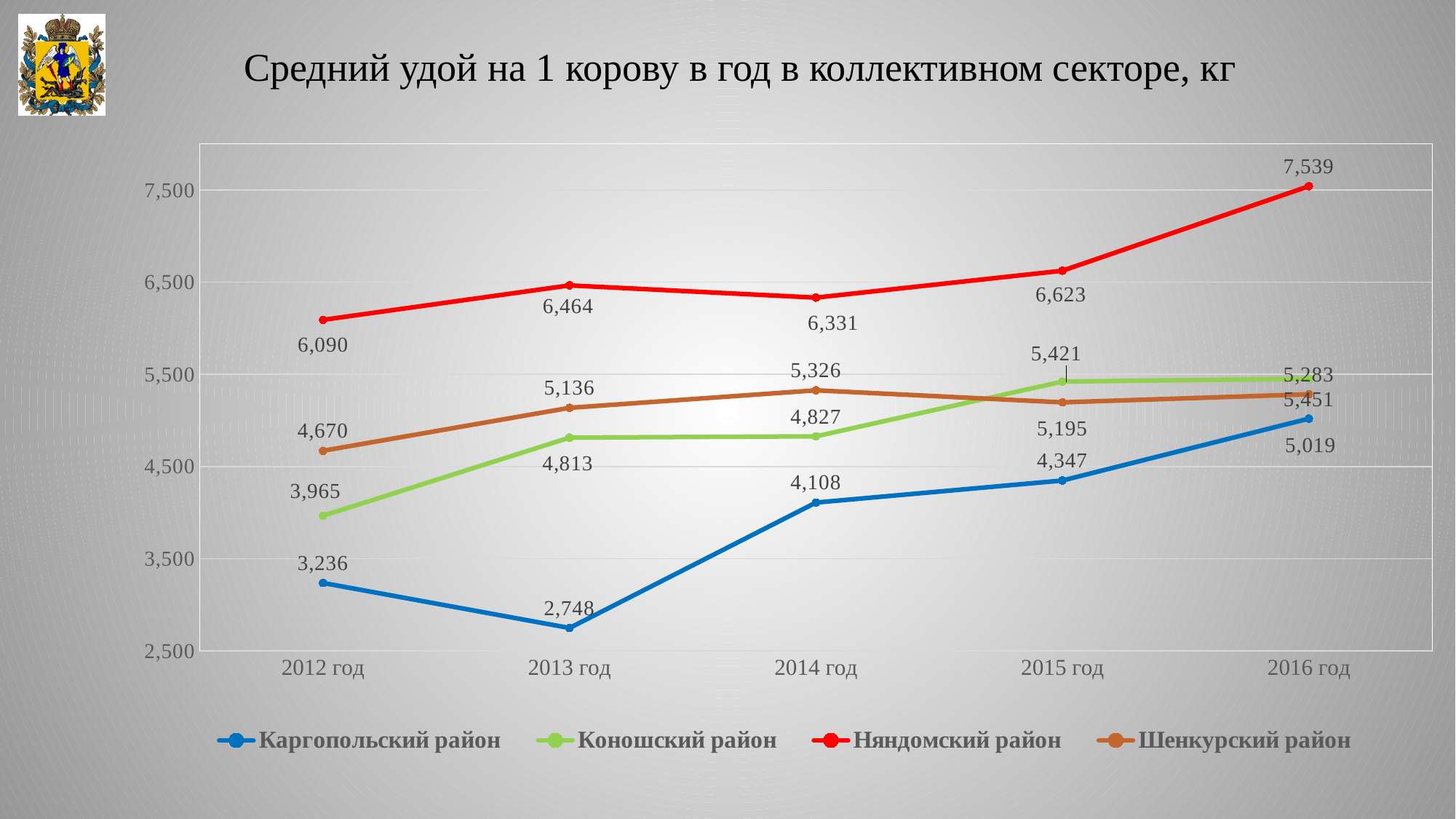
What is the difference between the values for Няндомский район in 2016 год and 2015 год? 916 Is the value for Каргопольский район in 2016 год greater or less than 4,500? greater How many series does the legend list? 4 What is the title of the chart? Средний удой на 1 корову в год в коллективном секторе, кг Which district has the highest value in 2014 год? Няндомский район What is the value for Няндомский район in 2016 год? 7,539 What is the value for Каргопольский район in 2013 год? 2,748 What kind of chart is shown on the slide? line chart In which year is the value for Каргопольский район lowest? 2013 год What is the value for Шенкурский район in 2014 год? 5,326 In 2012 год, which is larger: Коношский район or Шенкурский район? Шенкурский район How many years are shown on the x axis? 5